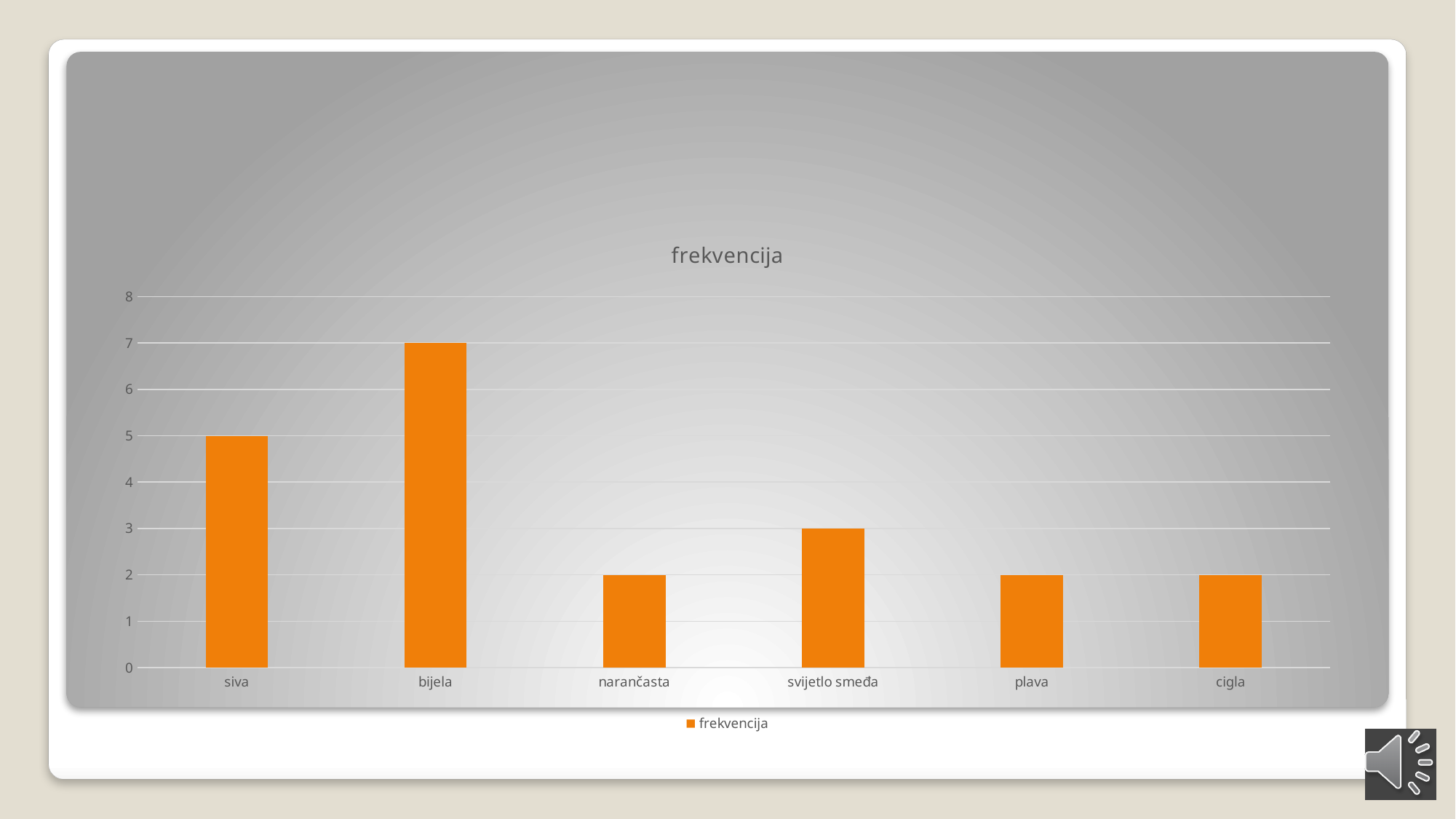
What colour are the bars? orange What is the value for siva? 5 What is the title of the chart? frekvencija What kind of chart is shown? bar chart How many categories are shown on the x axis? 6 Which category has the highest value? bijela How many series does the legend list? 1 Is the value for bijela greater or less than 6? greater What is the difference between the values for bijela and siva? 2 What is the value for svijetlo smeđa? 3 What is the value for bijela? 7 Which is larger, the value for siva or the value for svijetlo smeđa? siva